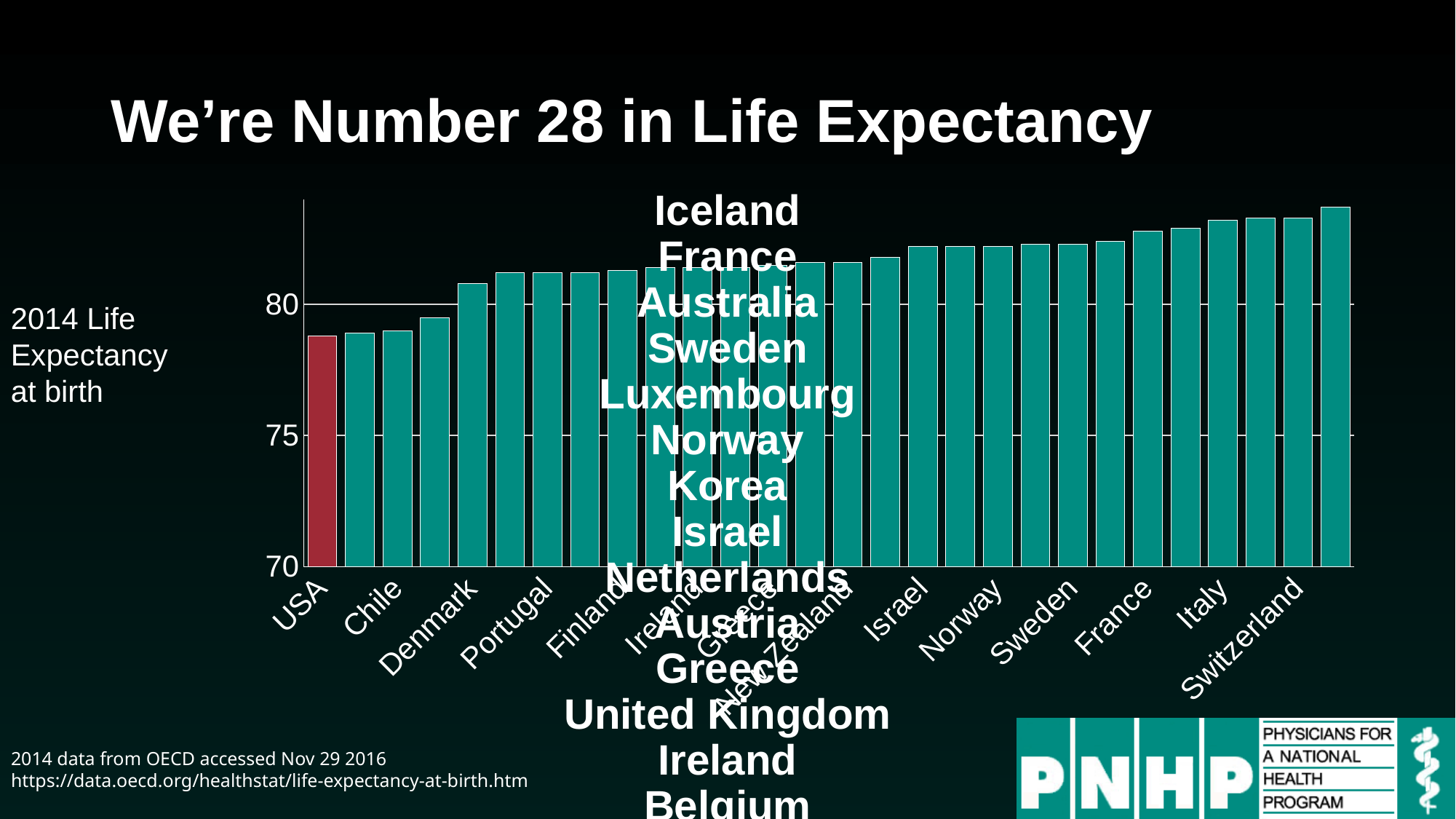
Is the value for Switzerland greater or less than 80? greater Is the value for Portugal greater or less than 80? greater Which has a higher life expectancy, Denmark or Portugal? Portugal Is the value for USA greater or less than 80? less How many countries (bars) are shown in the chart? 28 What kind of chart is shown on the slide? bar chart Which country has the lowest life expectancy in the chart? USA Which country's bar is shown in a different colour (red) from the others? USA Do the bars rise or fall from left to right along the x axis? rise Which has a higher life expectancy, Italy or Chile? Italy